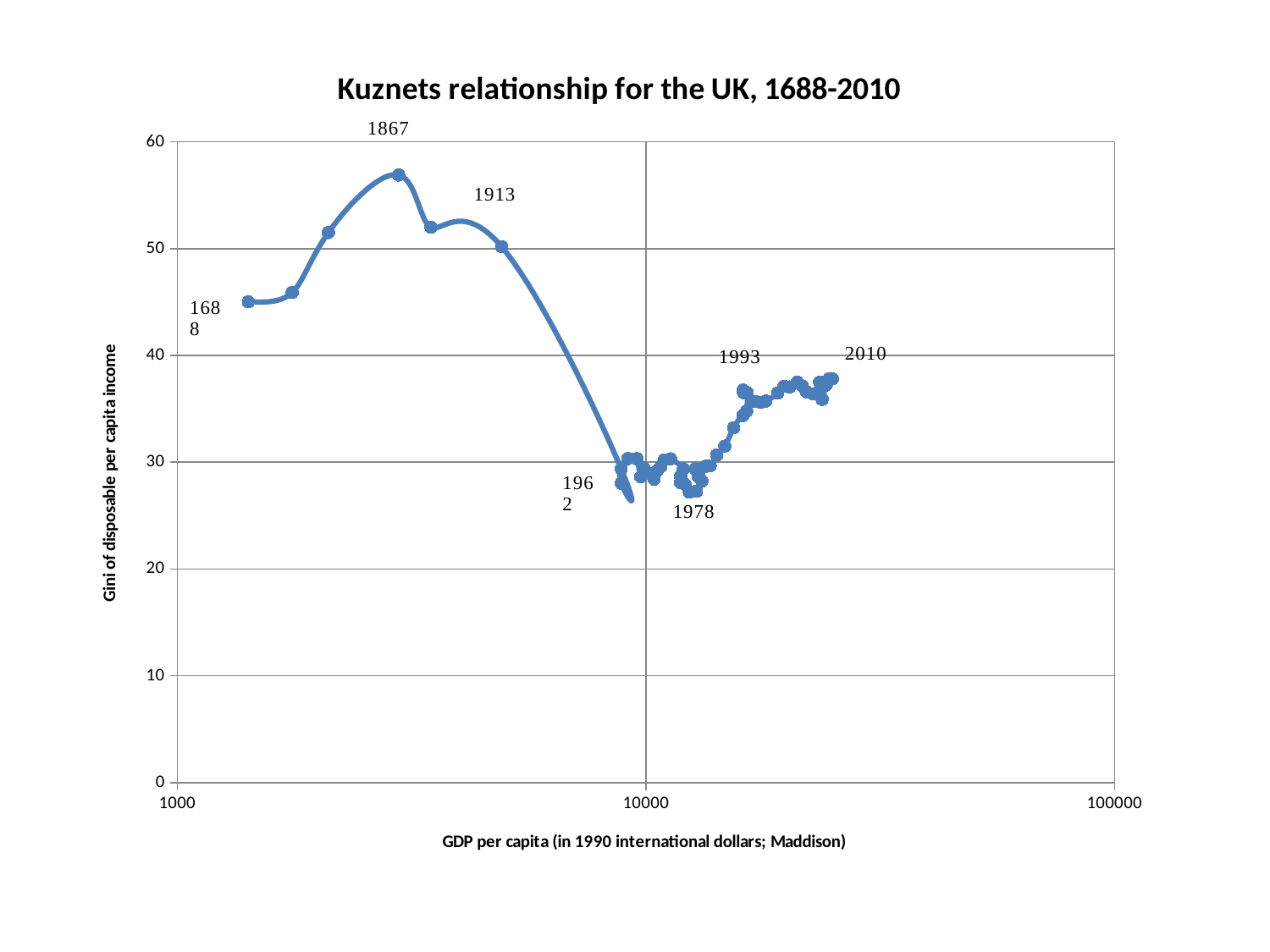
What is the label of the vertical axis? Gini of disposable per capita income Is the Gini value for 2010 greater or less than 40? less What is the title of the chart? Kuznets relationship for the UK, 1688-2010 Is the Gini value for 1993 greater or less than 30? greater Which labelled year has the highest Gini value on the chart? 1867 Is the Gini value for 1867 greater or less than 50? greater What kind of chart is shown on the slide? scatter chart Which has the higher Gini value, 1688 or 2010? 1688 Which has the higher Gini value, 1867 or 1913? 1867 Does the Gini value rise or fall between 1913 and 1962? fall